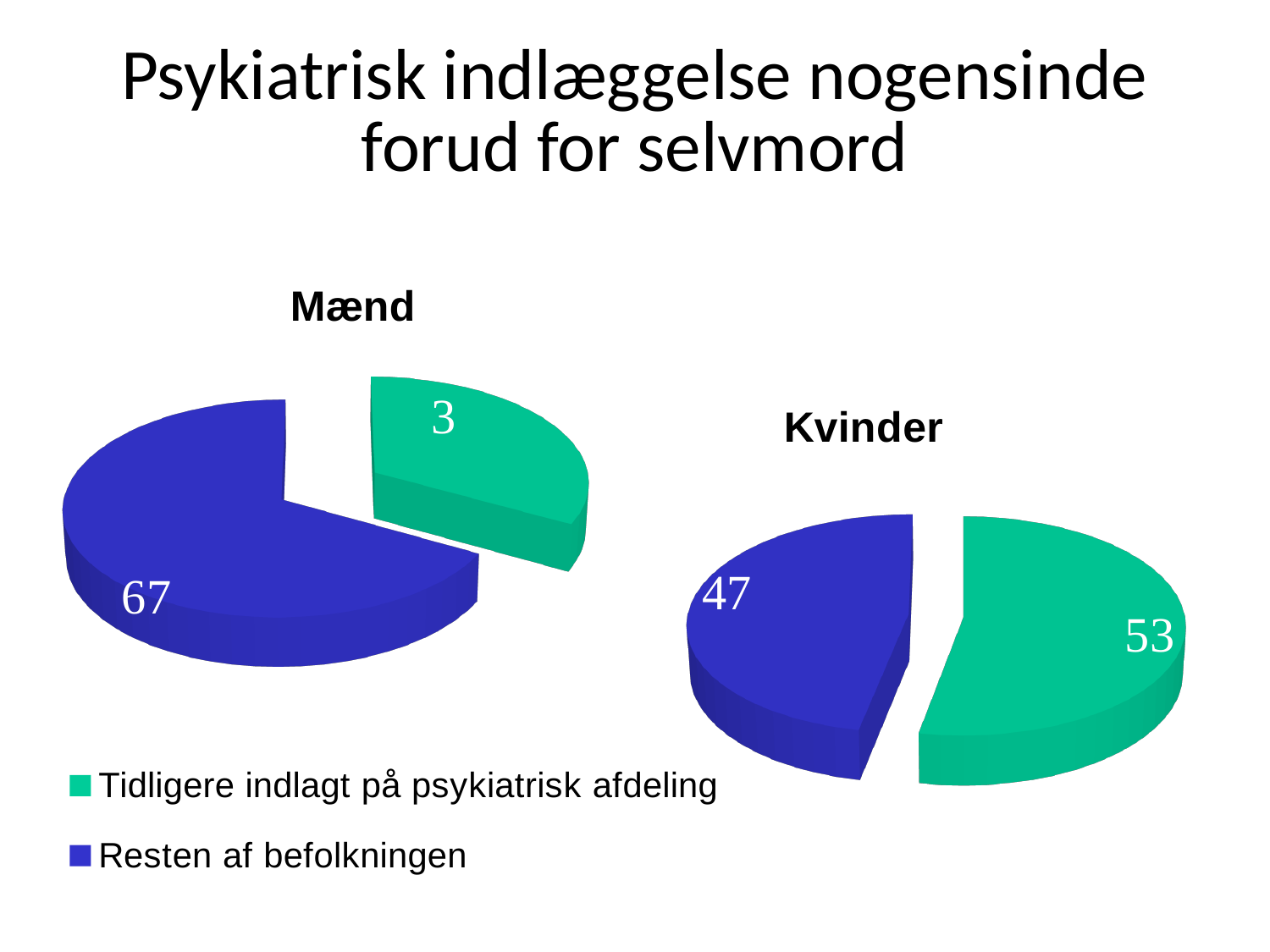
In the "Kvinder" chart, what is the total of the two slice values? 100 In the "Kvinder" chart, which slice is larger: "Tidligere indlagt på psykiatrisk afdeling" or "Resten af befolkningen"? Tidligere indlagt på psykiatrisk afdeling In the "Kvinder" chart, what is the value for "Resten af befolkningen"? 47 In the "Mænd" chart, which slice is the largest? Resten af befolkningen In the "Mænd" chart, which slice is the smallest? Tidligere indlagt på psykiatrisk afdeling In the "Mænd" chart, what is the value for "Resten af befolkningen"? 67 In the "Kvinder" chart, what is the value for "Tidligere indlagt på psykiatrisk afdeling"? 53 In the "Kvinder" chart, what is the difference between the values for "Tidligere indlagt på psykiatrisk afdeling" and "Resten af befolkningen"? 6 What kind of chart is the "Mænd" chart? pie chart How many entries does the legend list? 2 What colour represents "Resten af befolkningen" in the charts? blue How many slices does the "Kvinder" chart have? 2